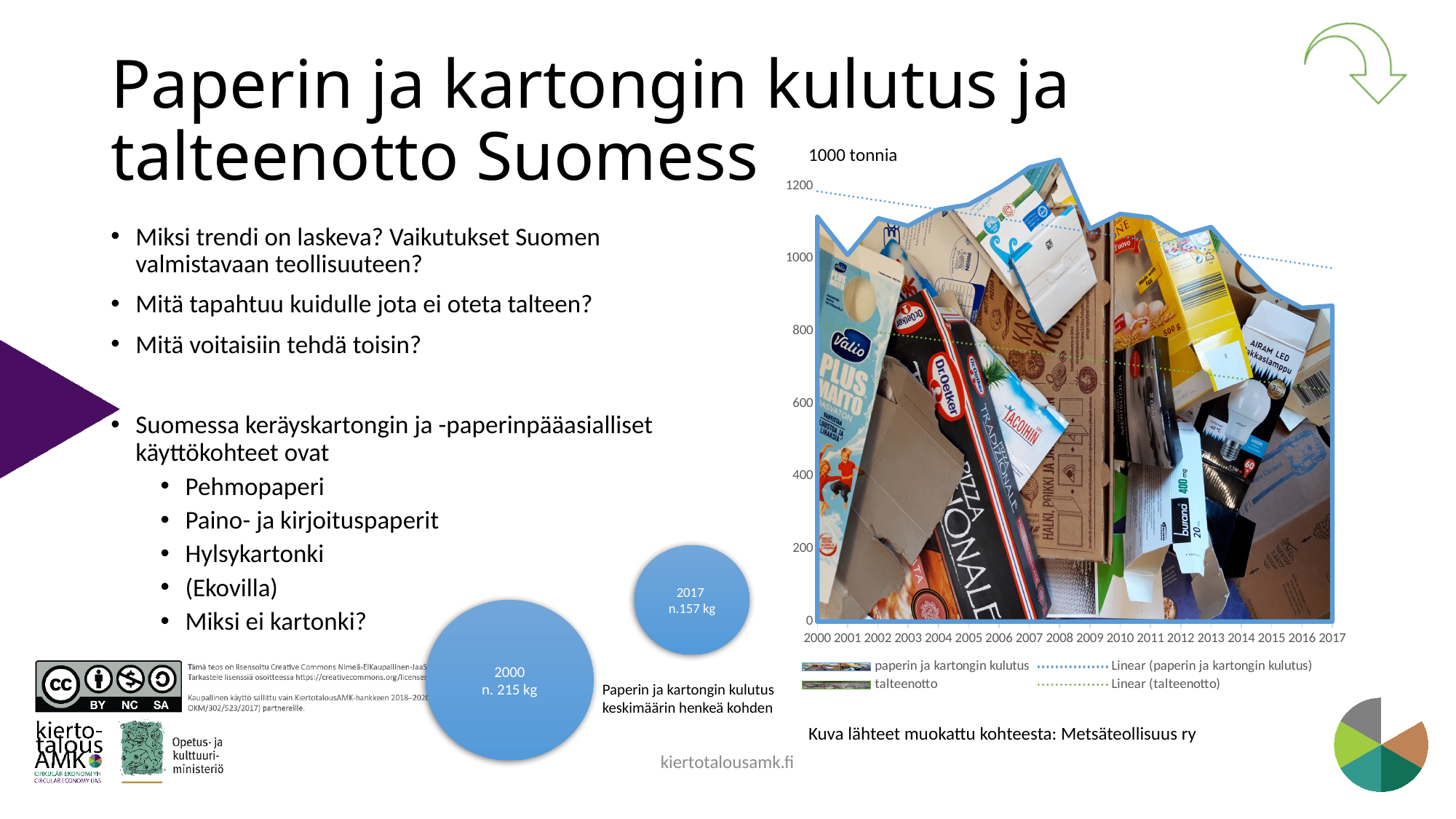
What is the highest value shown on the chart's y axis? 1200 Is the value for 'paperin ja kartongin kulutus' in 2007 greater or less than 1000? greater How many entries does the chart legend list? 4 What kind of chart is shown on the right of the slide? area chart How many years are shown on the x axis of the chart? 18 Which year has the larger value for 'paperin ja kartongin kulutus', 2000 or 2017? 2000 What unit label is shown above the chart's y axis? 1000 tonnia In which year is 'paperin ja kartongin kulutus' highest? 2008 Is the value for 'paperin ja kartongin kulutus' in 2000 greater or less than 1000? greater Does the 'paperin ja kartongin kulutus' series rise or fall overall from 2000 to 2017? fall Is the value for 'paperin ja kartongin kulutus' in 2017 greater or less than 1000? less What is the first year shown on the chart's x axis? 2000